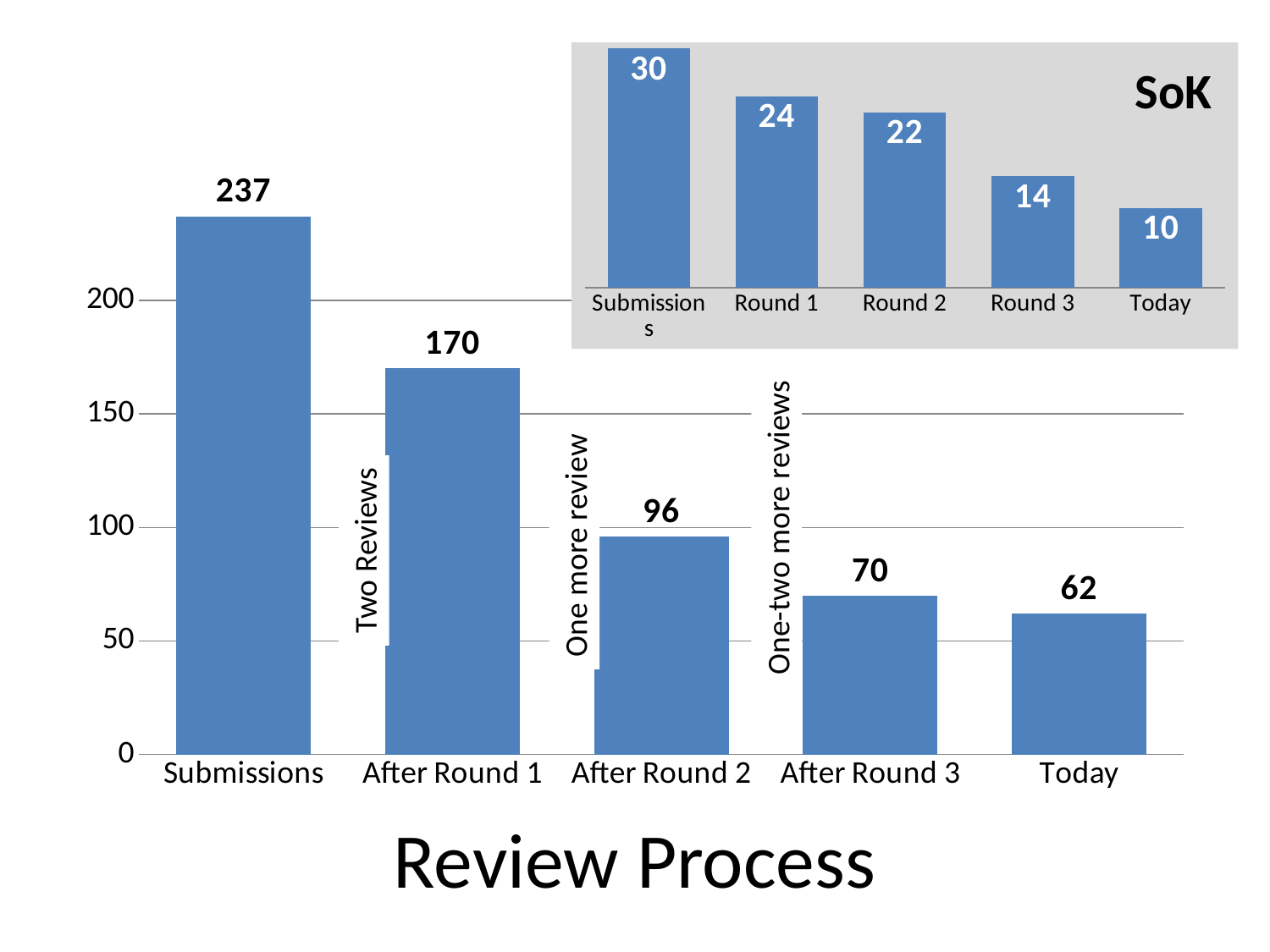
What kind of chart is the main Review Process chart? bar chart In the main Review Process chart, how many categories are shown on the x axis? 5 In the main Review Process chart, what is the value for After Round 2? 96 In the main Review Process chart, do the values rise or fall from Submissions to Today? fall In the main Review Process chart, what is the value for Today? 62 In the SoK inset chart, what is the difference between Round 1 and Round 3? 10 In the SoK inset chart, what is the value for Today? 10 In the main Review Process chart, what is the difference between Submissions and After Round 1? 67 In the main Review Process chart, what is the value for Submissions? 237 In the SoK inset chart, which category has the highest value? Submissions In the main Review Process chart, which category has the lowest value? Today In the SoK inset chart, what is the value for Round 2? 22